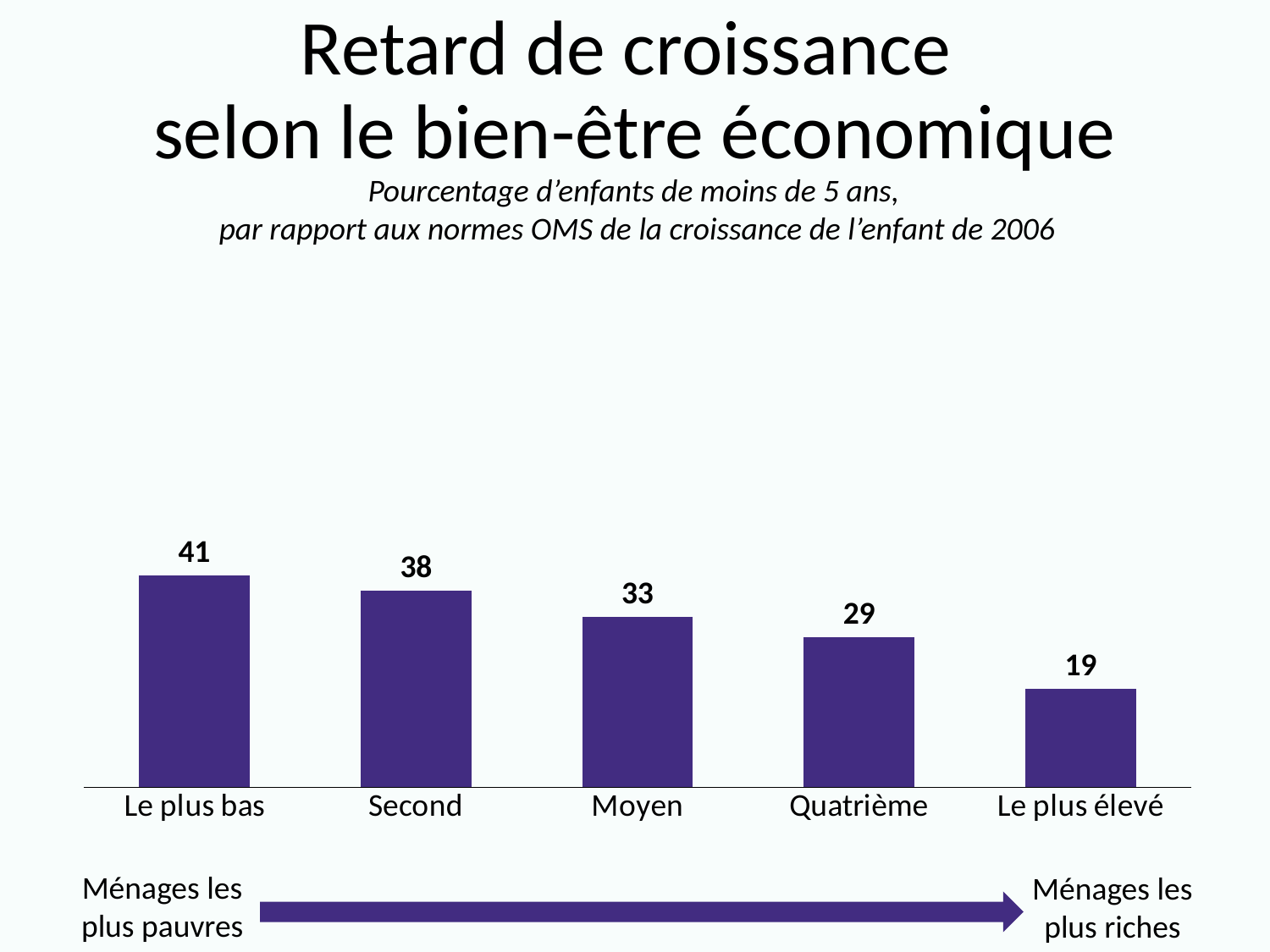
What is the difference between the values for Le plus bas and Le plus élevé? 22 Which is larger, the value for Second or the value for Quatrième? Second What is the difference between the values for Second and Moyen? 5 What is the value for Le plus élevé? 19 How many categories are shown on the x axis? 5 Do the values rise or fall from left to right along the x axis? Fall What is the value for Moyen? 33 What kind of chart is this? Bar chart Which category has the highest value? Le plus bas Which category has the lowest value? Le plus élevé What is the value for Le plus bas? 41 What is the value for Quatrième? 29